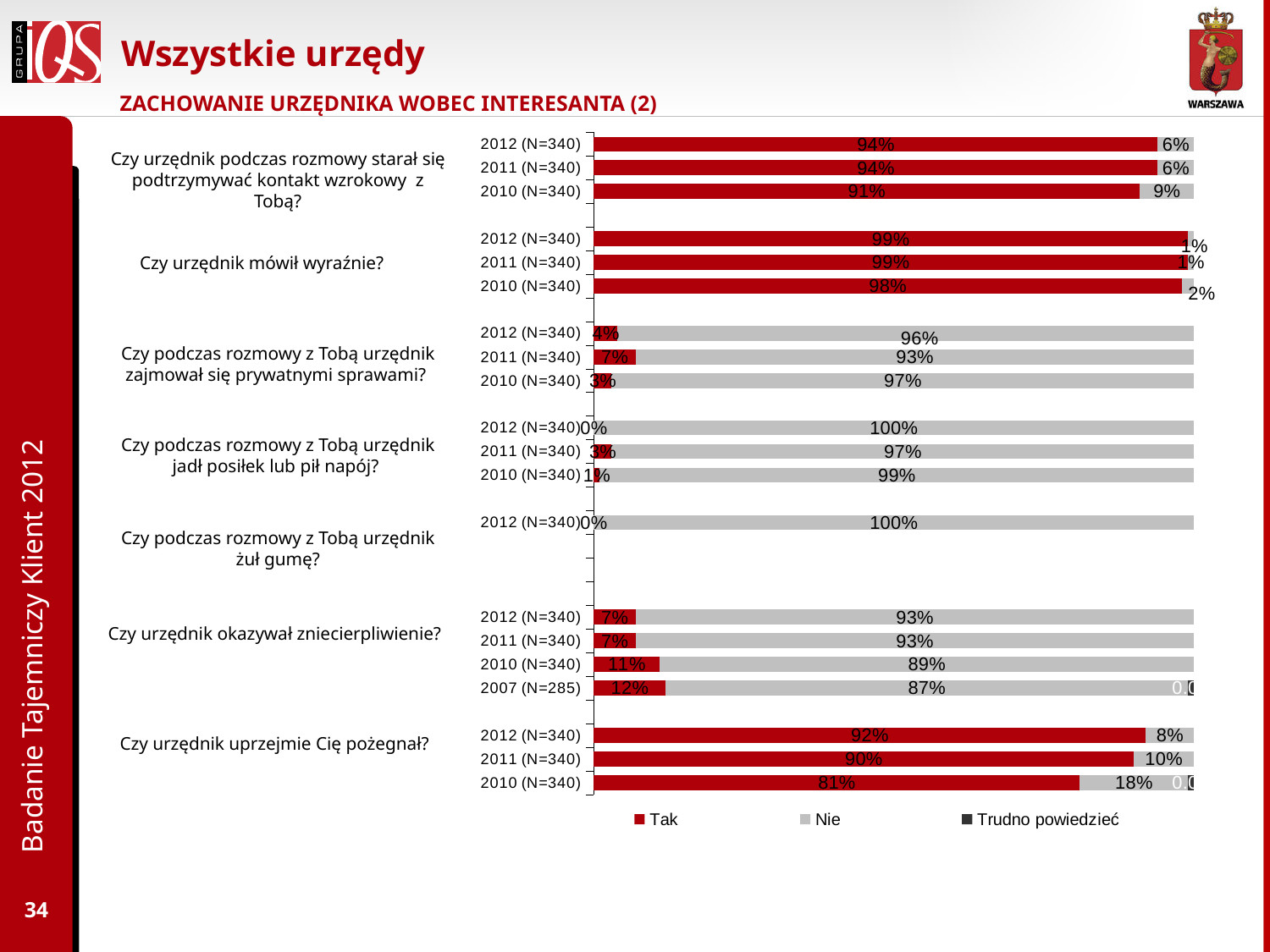
What is the "Nie" value for 2012 (N=340) for the question "Czy podczas rozmowy z Tobą urzędnik zajmował się prywatnymi sprawami?"? 96% What type of chart is shown on the slide? stacked bar chart How many series does the legend list? 3 What is the "Tak" value for 2010 (N=340) for the question "Czy urzędnik podczas rozmowy starał się podtrzymywać kontakt wzrokowy z Tobą?"? 91% For the question "Czy urzędnik uprzejmie Cię pożegnał?", which year has the lowest "Tak" value? 2010 (N=340) What is the difference between the "Tak" values for 2012 (N=340) and 2010 (N=340) for the question "Czy urzędnik uprzejmie Cię pożegnał?"? 11% For the question "Czy urzędnik okazywał zniecierpliwienie?", which year has the highest "Tak" value? 2007 (N=285) How many year rows are shown for the question "Czy urzędnik okazywał zniecierpliwienie?"? 4 What is the "Nie" value for 2012 (N=340) for the question "Czy podczas rozmowy z Tobą urzędnik żuł gumę?"? 100% What is the "Nie" value for 2010 (N=340) for the question "Czy urzędnik uprzejmie Cię pożegnał?"? 18% For the question "Czy podczas rozmowy z Tobą urzędnik zajmował się prywatnymi sprawami?", which is larger: the "Tak" value for 2011 (N=340) or for 2010 (N=340)? 2011 (N=340) What is the "Tak" value for 2007 (N=285) for the question "Czy urzędnik okazywał zniecierpliwienie?"? 12%